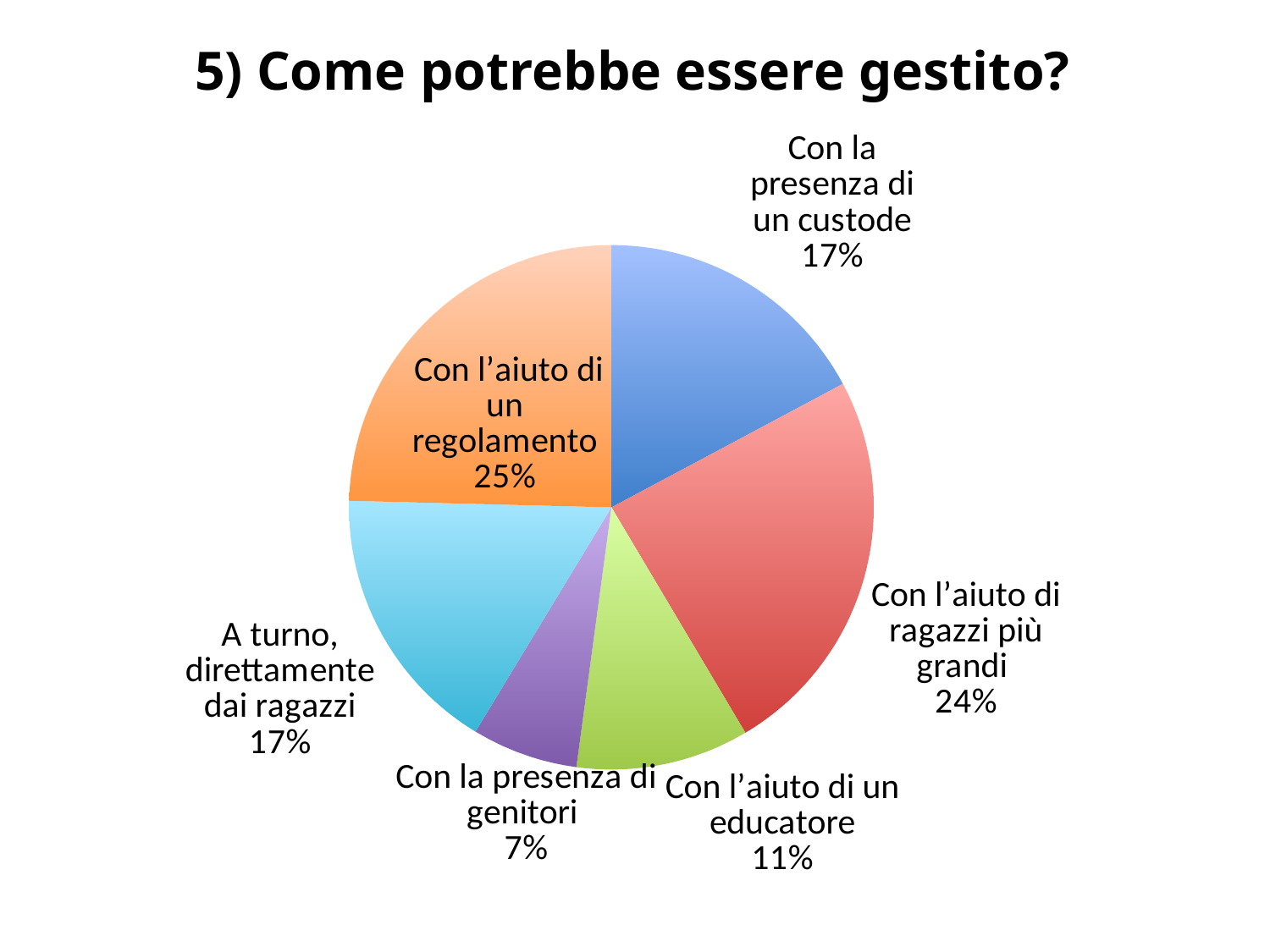
Which is larger: "Con l'aiuto di un educatore" or "A turno, direttamente dai ragazzi"? A turno, direttamente dai ragazzi What kind of chart is shown on the slide? pie chart What share of the pie is "Con la presenza di un custode"? 17% What share of the pie is "Con l'aiuto di un educatore"? 11% What share of the pie is "Con la presenza di genitori"? 7% Which category has the smallest slice of the pie? Con la presenza di genitori How many slices does the pie chart have? 6 Which category has the largest slice of the pie? Con l'aiuto di un regolamento What is the difference in percentage points between "Con l'aiuto di un regolamento" and "Con la presenza di genitori"? 18 What is the title of the chart? 5) Come potrebbe essere gestito?